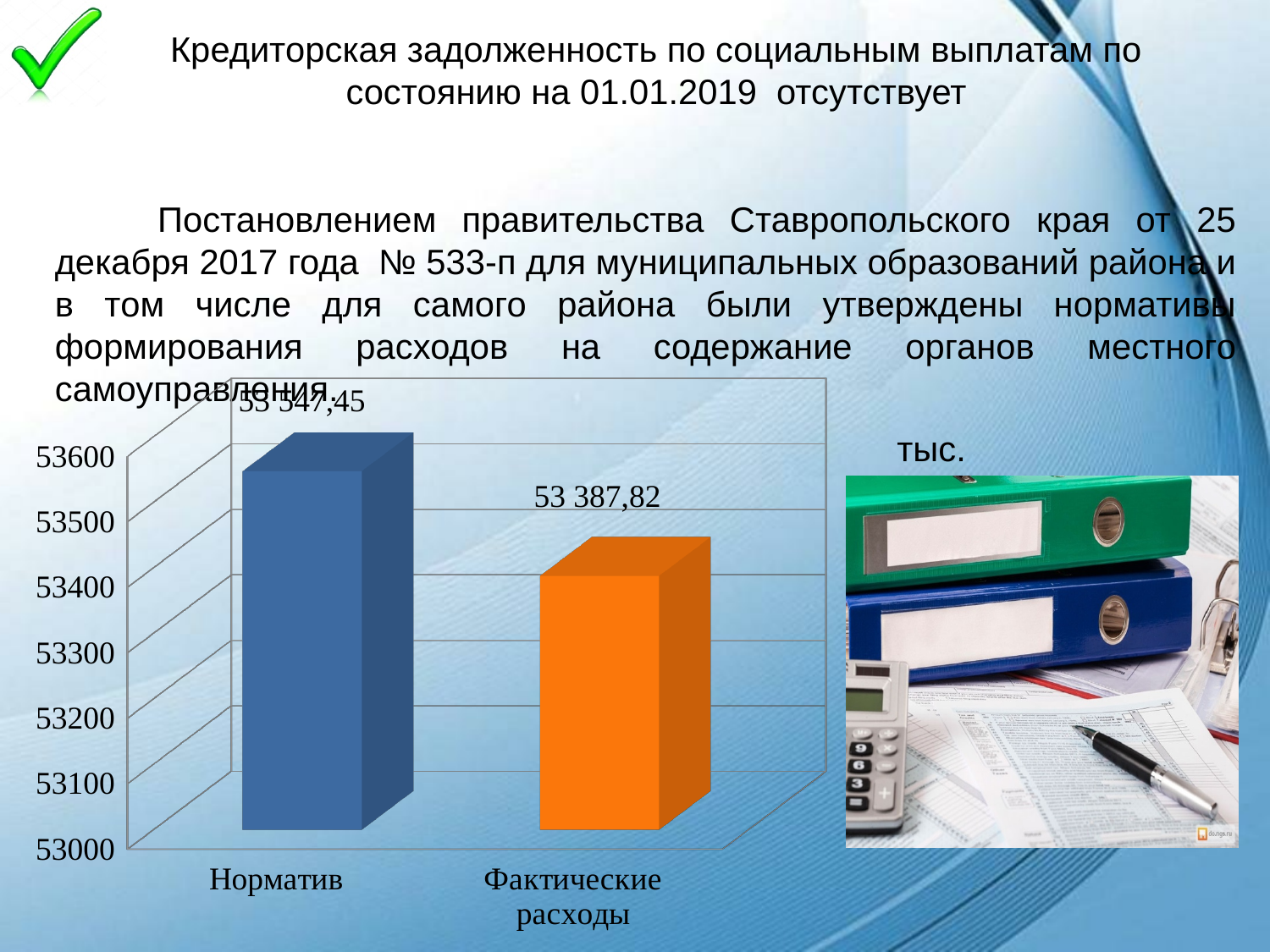
How many categories are shown on the chart? 2 Which is larger, the value for Норматив or the value for Фактические расходы? Норматив What kind of chart is shown on the slide? bar chart What is the difference between the values for Норматив and Фактические расходы? 159,63 Which category has the highest value? Норматив What is the value for Фактические расходы? 53 387,82 What colour is the bar for Фактические расходы? orange Is the value for Норматив greater or less than 53500? greater Is the value for Фактические расходы greater or less than 53300? greater Which category has the lowest value? Фактические расходы What is the lowest value shown on the vertical axis of the chart? 53000 What is the value for Норматив? 53 547,45